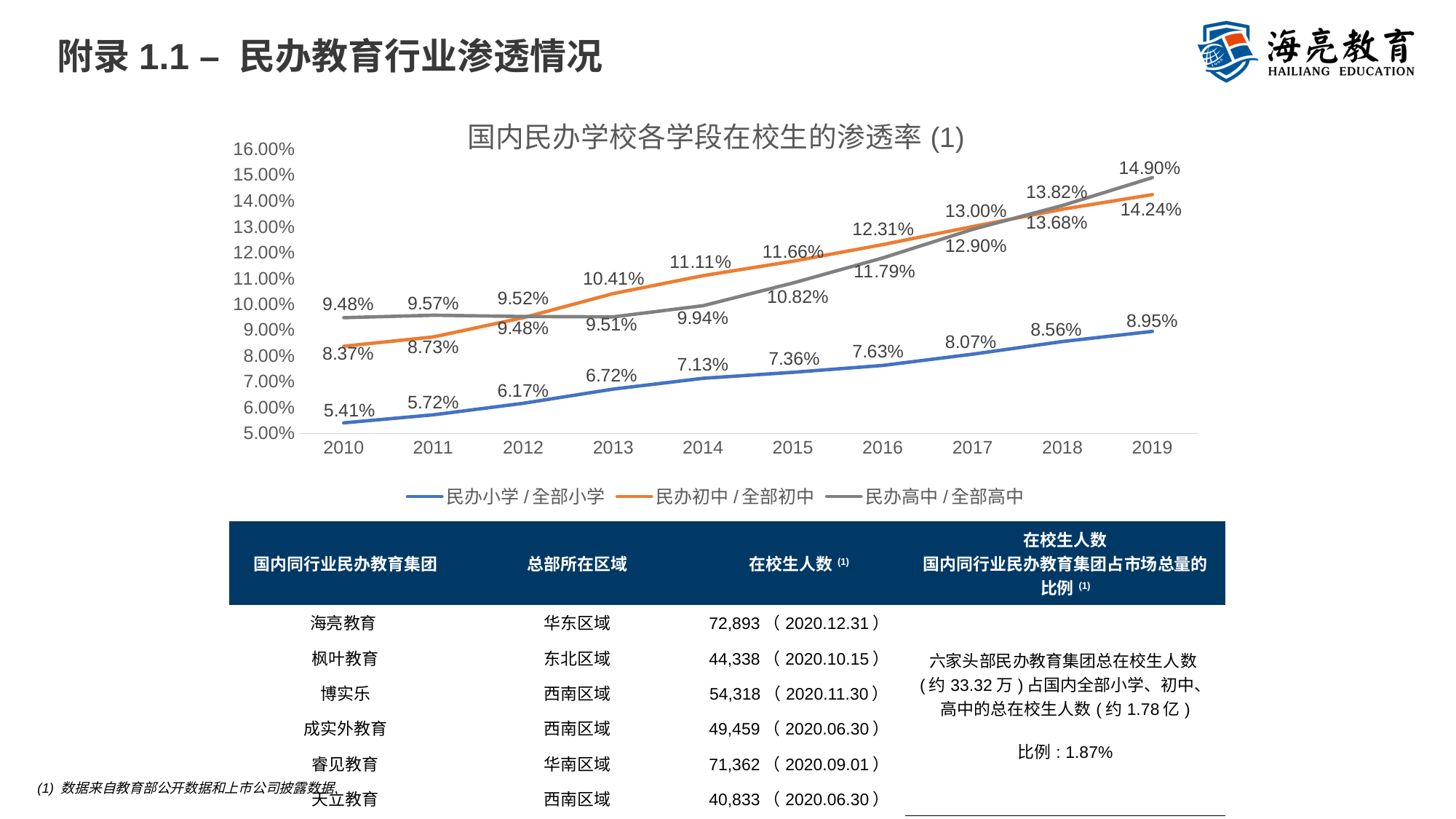
What is the value for 民办初中 / 全部初中 in 2015? 11.66% How many series does the chart legend list? 3 In which year is the 民办高中 / 全部高中 series at its highest? 2019 How many years are plotted along the x axis of the chart? 10 What is the value for 民办高中 / 全部高中 in 2010? 9.48% What is the title of the chart? 国内民办学校各学段在校生的渗透率 (1) Does the 民办小学 / 全部小学 series rise or fall from 2010 to 2019? rise Which series has the higher value in 2019, 民办初中 / 全部初中 or 民办高中 / 全部高中? 民办高中 / 全部高中 In which year is the 民办小学 / 全部小学 series at its lowest? 2010 What is the difference between the 民办初中 / 全部初中 values in 2019 and 2010? 5.87% What type of chart is shown on the slide? line chart What is the value for 民办小学 / 全部小学 in 2019? 8.95%